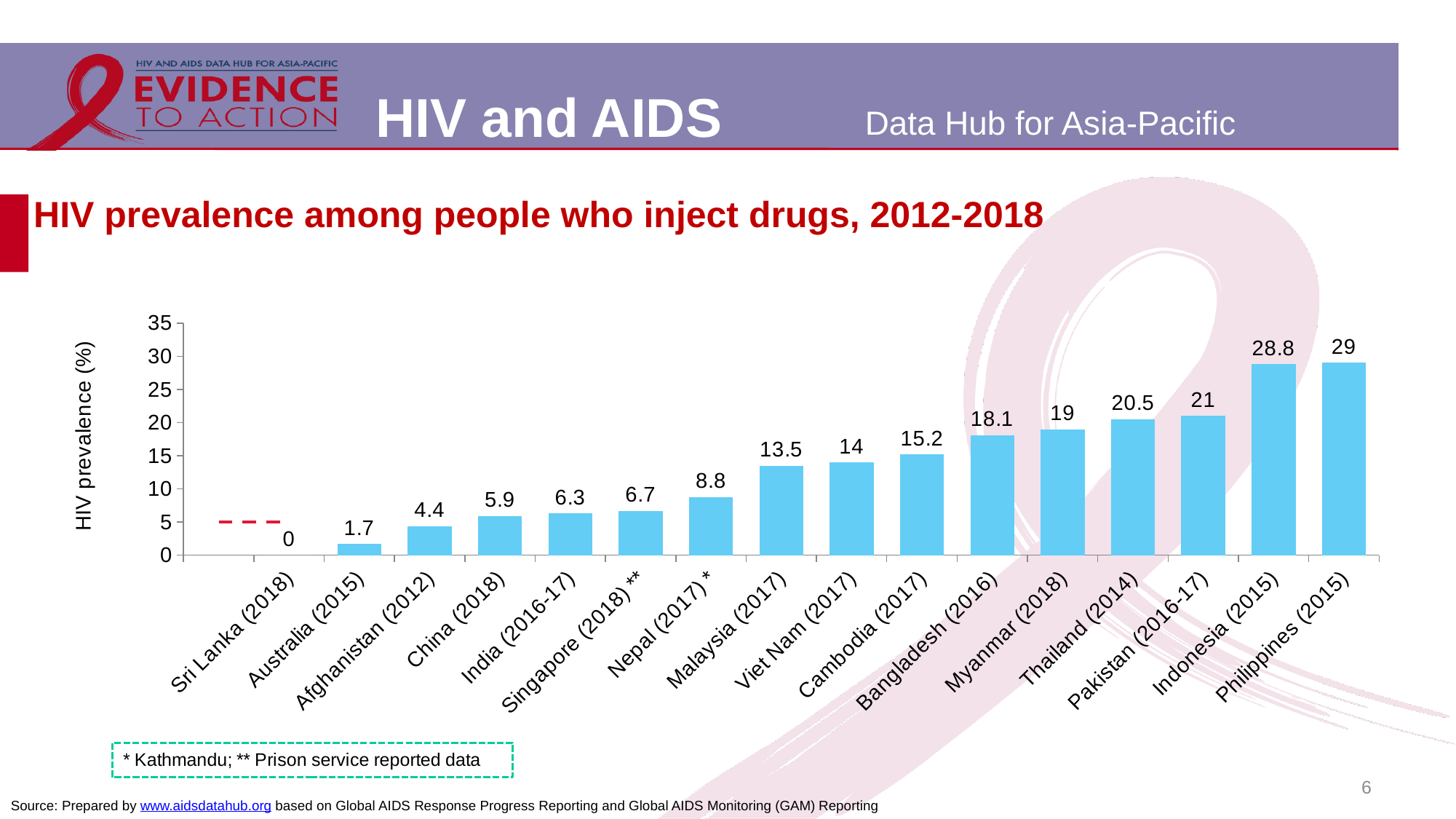
What is the HIV prevalence among people who inject drugs in Malaysia (2017)? 13.5 Which has a higher HIV prevalence among people who inject drugs: Bangladesh (2016) or Viet Nam (2017)? Bangladesh (2016) Is the HIV prevalence for Pakistan (2016-17) greater or less than 20? greater Do the values rise or fall from left to right along the x axis? Rise Which country has the highest HIV prevalence among people who inject drugs on the chart? Philippines (2015) What is the HIV prevalence among people who inject drugs in Nepal (2017)? 8.8 What type of chart is used on the slide? Bar chart How many countries are shown on the chart? 16 Which country has the lowest HIV prevalence among people who inject drugs on the chart? Sri Lanka (2018) What is the HIV prevalence among people who inject drugs in Indonesia (2015)? 28.8 What is the label of the vertical axis? HIV prevalence (%) What is the difference in HIV prevalence between Thailand (2014) and Cambodia (2017)? 5.3